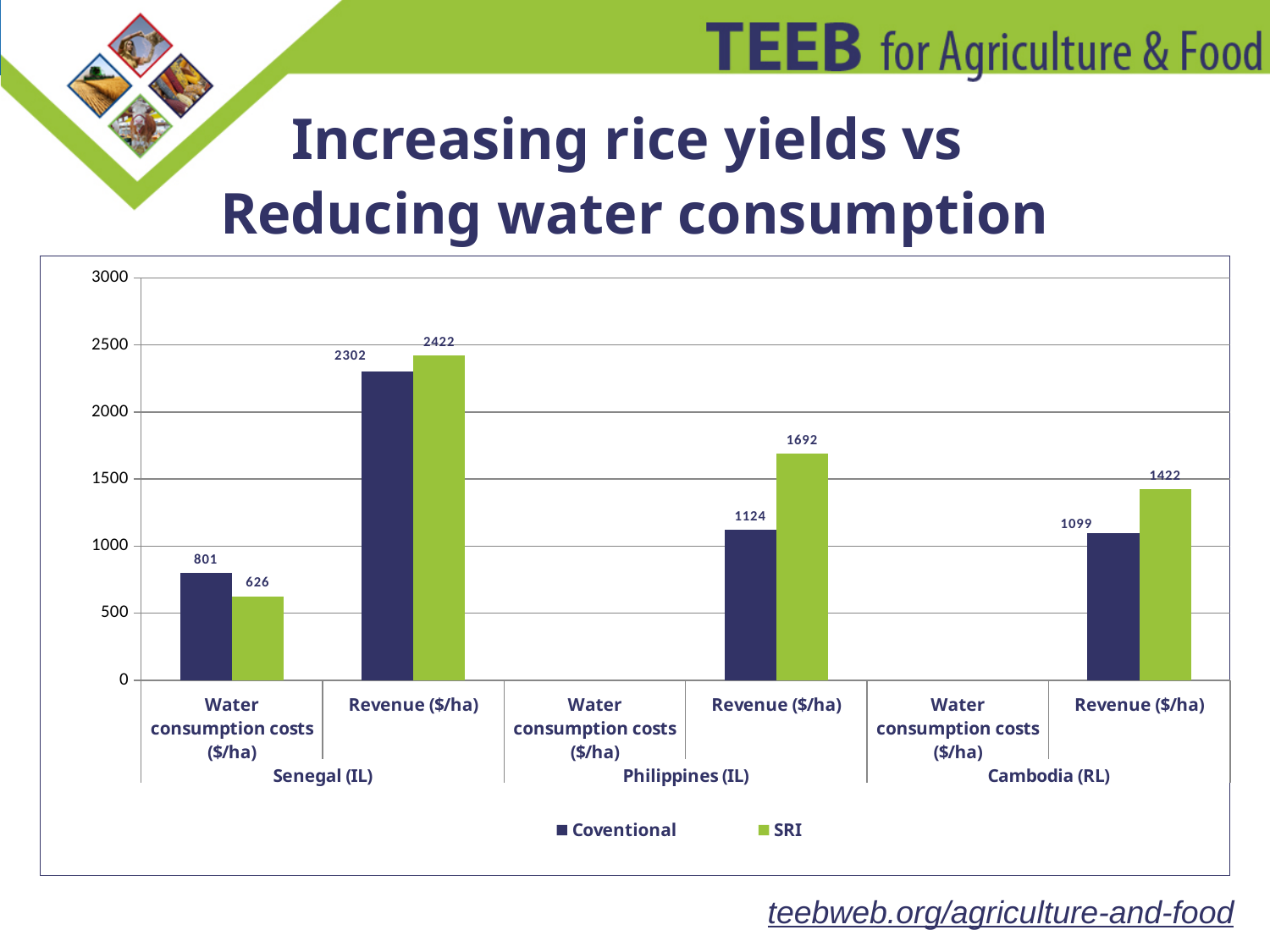
What kind of chart is shown on the slide? Bar chart Is the Coventional Revenue ($/ha) value for Senegal (IL) greater or less than 2000? greater What is the SRI value for Water consumption costs ($/ha) in Senegal (IL)? 626 For Revenue ($/ha) in Cambodia (RL), which is larger: Coventional or SRI? SRI Which bar has the highest value on the chart? SRI Revenue ($/ha) for Senegal (IL) Which bar has the lowest value on the chart? SRI Water consumption costs ($/ha) for Senegal (IL) What is the difference between the Coventional and SRI Water consumption costs ($/ha) values for Senegal (IL)? 175 What is the Coventional value for Water consumption costs ($/ha) in Senegal (IL)? 801 How many series does the legend list? 2 What is the difference between the SRI and Coventional Revenue ($/ha) values for Philippines (IL)? 568 What is the SRI value for Revenue ($/ha) in Philippines (IL)? 1692 What is the Coventional value for Revenue ($/ha) in Cambodia (RL)? 1099